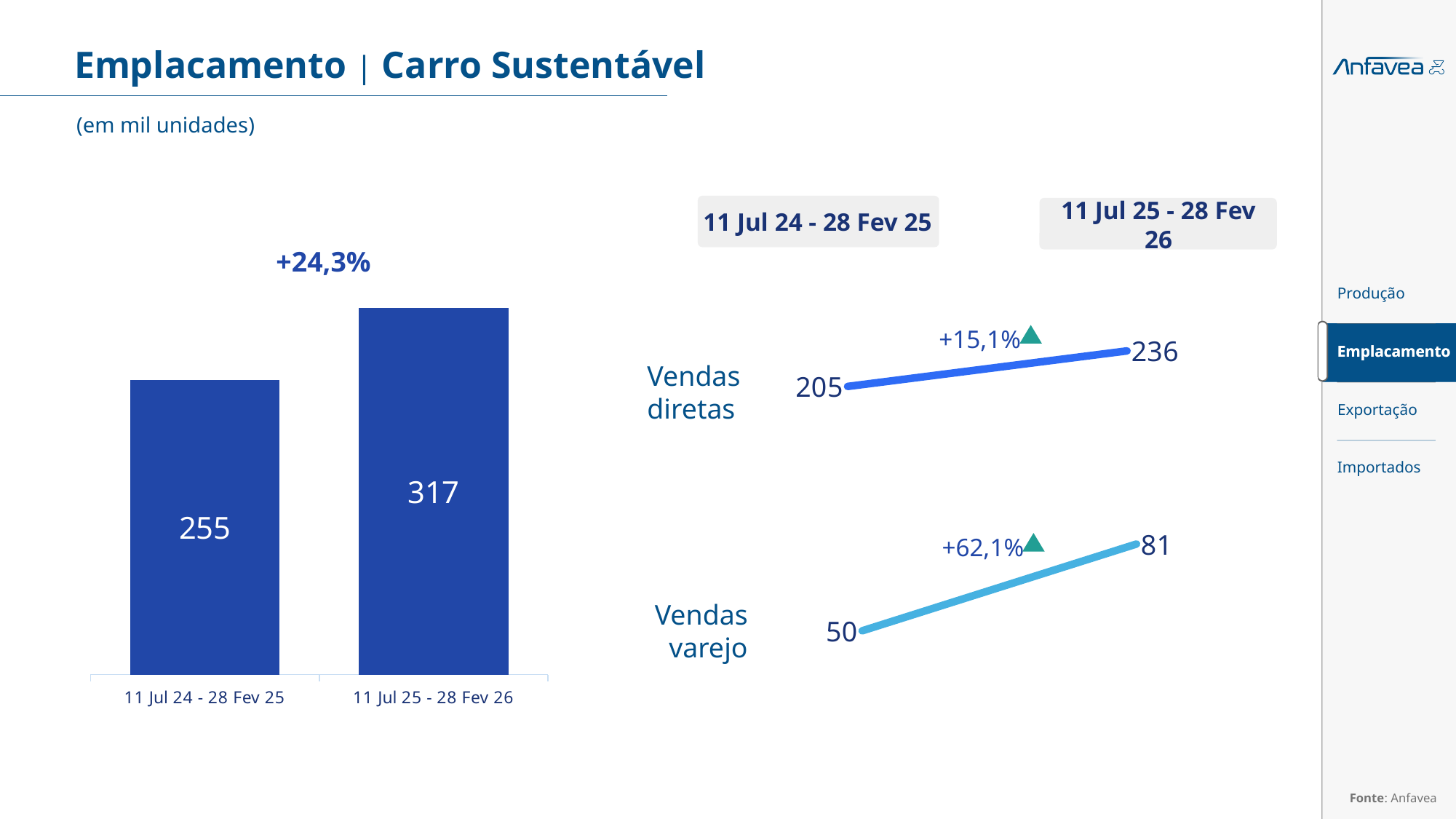
In the line chart on the right, what is the difference between Vendas varejo in 11 Jul 25 - 28 Fev 26 and in 11 Jul 24 - 28 Fev 25? 31 What kind of chart is shown on the left of the slide? bar chart In the line chart on the right, what is the value of Vendas diretas for 11 Jul 25 - 28 Fev 26? 236 How many bars are in the bar chart on the left? 2 In the bar chart on the left, what percentage change is shown above the bars? +24,3% In the line chart on the right, what percentage change is shown for Vendas varejo? +62,1% In the bar chart on the left, what is the value for 11 Jul 24 - 28 Fev 25? 255 In the bar chart on the left, what is the difference between the 11 Jul 25 - 28 Fev 26 bar and the 11 Jul 24 - 28 Fev 25 bar? 62 In the line chart on the right, do the Vendas diretas values rise or fall from 11 Jul 24 - 28 Fev 25 to 11 Jul 25 - 28 Fev 26? rise In the bar chart on the left, which period has the higher value? 11 Jul 25 - 28 Fev 26 In the bar chart on the left, what is the value for 11 Jul 25 - 28 Fev 26? 317 In the line chart on the right, what is the value of Vendas varejo for 11 Jul 24 - 28 Fev 25? 50